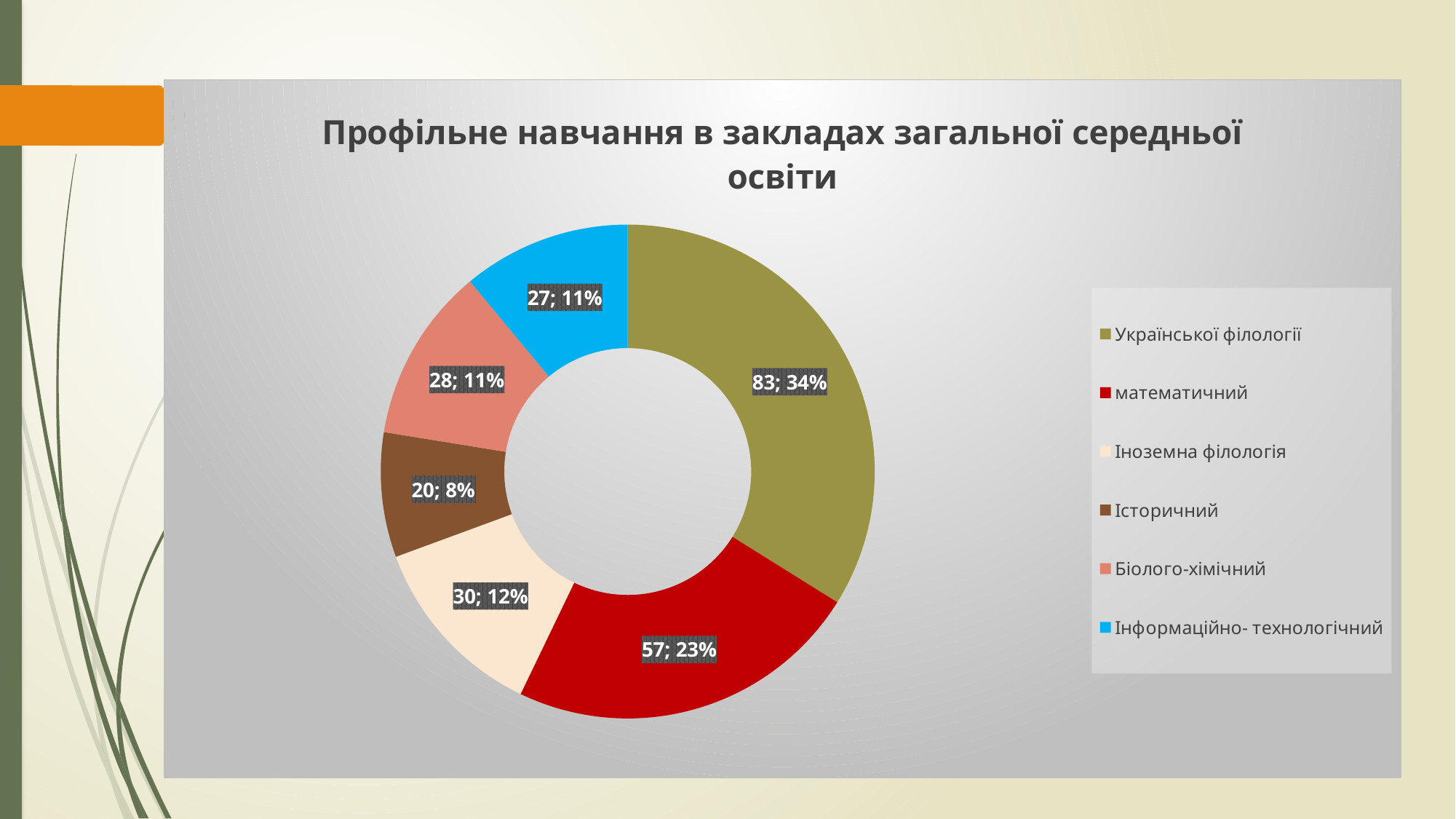
What is the value for Української філології? 83 Which is larger, the value for Біолого-хімічний or the value for Іноземна філологія? Іноземна філологія What percentage share does Іноземна філологія have? 12% What is the difference between the values for Української філології and математичний? 26 Which category has the lowest value? Історичний Which category has the highest value? Української філології What percentage share does Інформаційно- технологічний have? 11% How many categories does the chart show? 6 What kind of chart is shown on the slide? Pie chart (doughnut) What is the value for математичний? 57 What is the title of the chart? Профільне навчання в закладах загальної середньої освіти What is the value for Історичний? 20